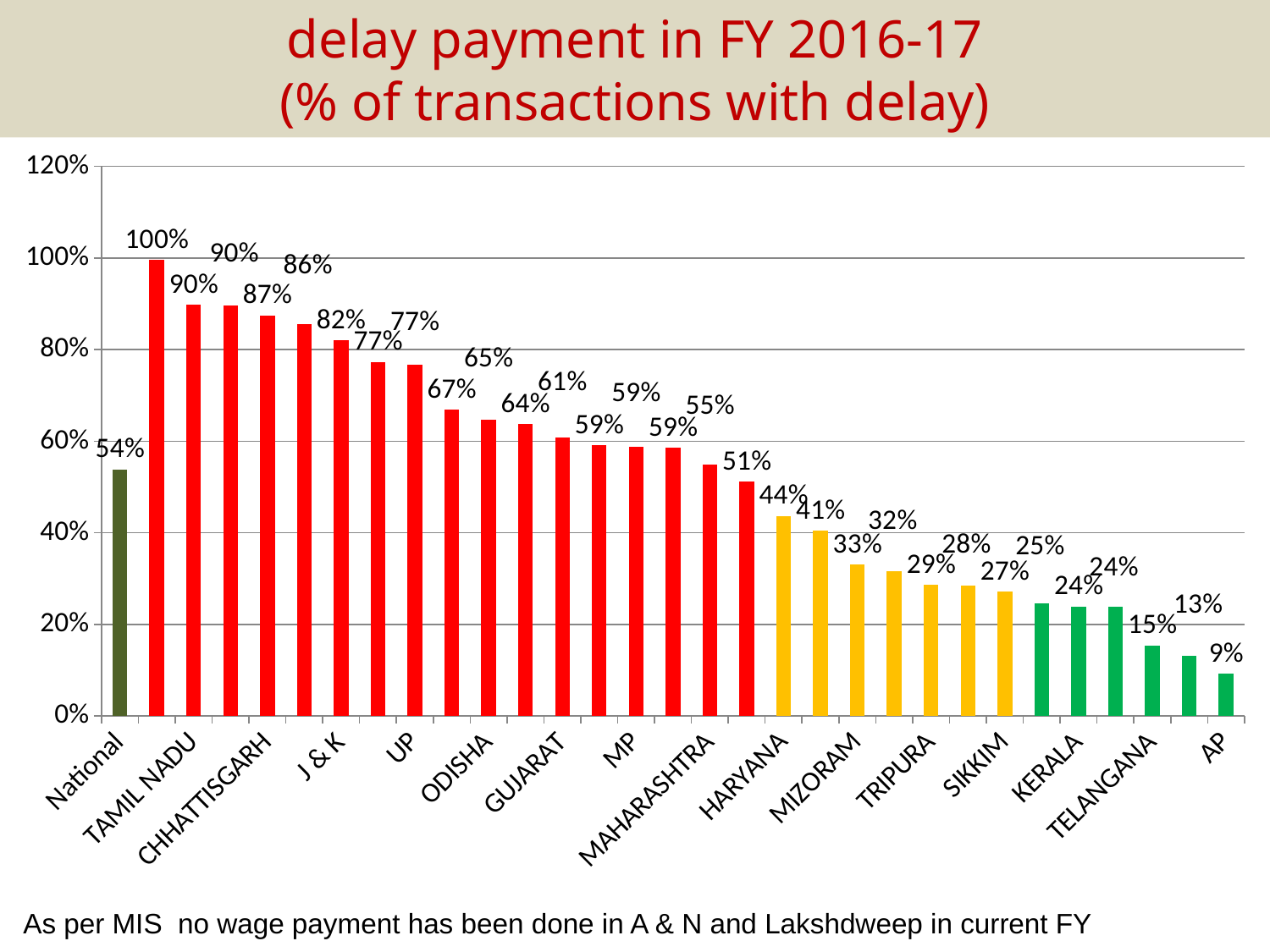
What is the value for UP? 77% Which of the labelled states has the lowest value? AP What is the value for HARYANA? 44% Is the value for ODISHA greater or less than 60%? greater Do the values rise or fall from left to right along the x axis? fall What is the subtitle in parentheses under the chart title? (% of transactions with delay) What is the difference between the values for TAMIL NADU and AP? 81 percentage points What is the value for AP? 9% What kind of chart is shown on the slide? bar chart What is the value for National? 54% Which is larger, the value for MIZORAM or the value for TRIPURA? MIZORAM What is the value for TAMIL NADU? 90%